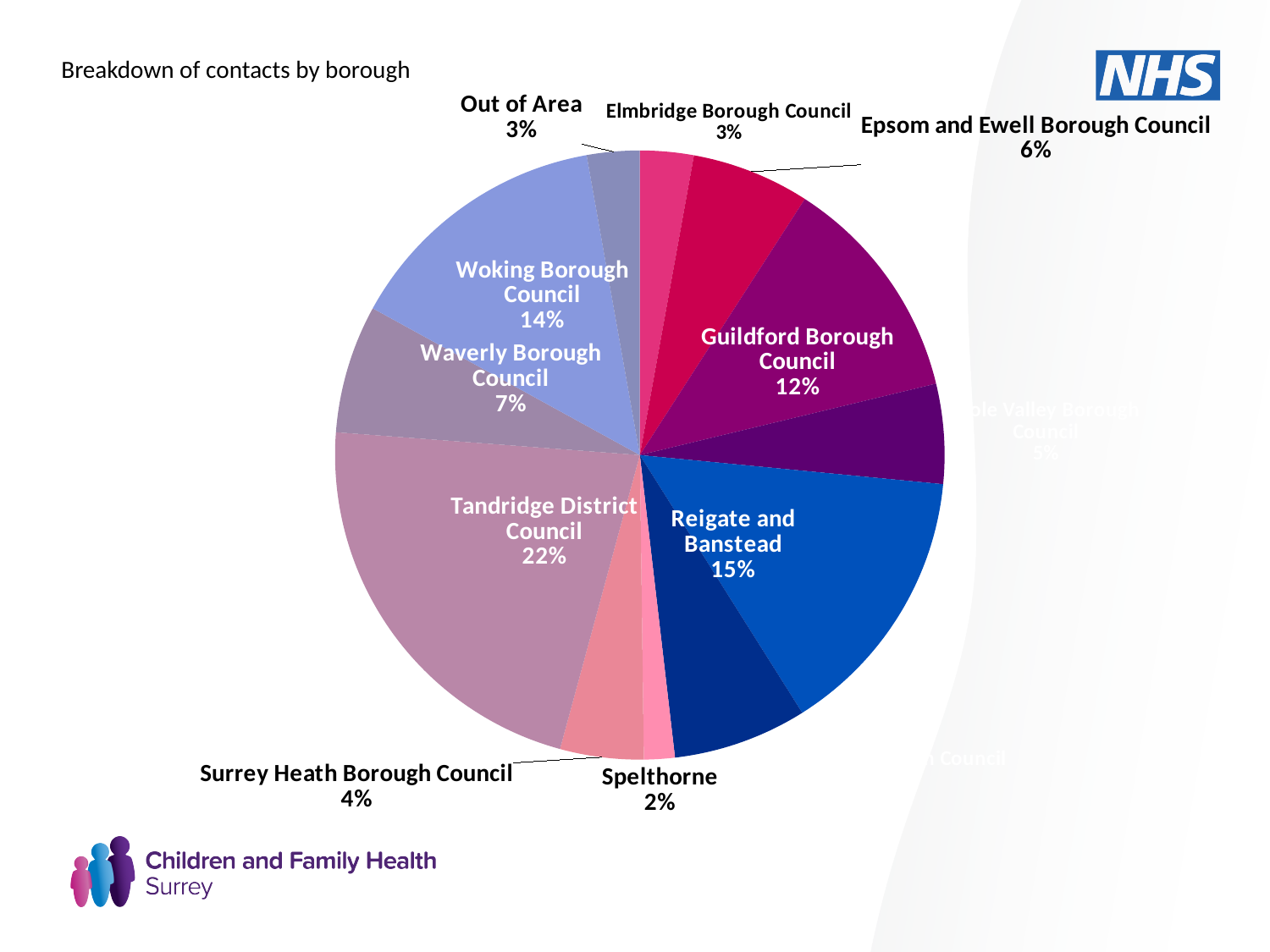
What percentage of contacts is from Woking Borough Council? 14% What percentage of contacts is from Reigate and Banstead? 15% What percentage of contacts is from Surrey Heath Borough Council? 4% What kind of chart is shown on the slide? pie chart What is the title of the chart? Breakdown of contacts by borough Which labelled borough has the smallest share of contacts? Spelthorne What share of contacts is from Tandridge District Council? 22% How many percentage points larger is the Tandridge District Council share than the Reigate and Banstead share? 7 Which has a larger share of contacts, Woking Borough Council or Waverly Borough Council? Woking Borough Council Which borough has the largest share of contacts? Tandridge District Council What percentage of contacts is from Guildford Borough Council? 12% What percentage of contacts is from Epsom and Ewell Borough Council? 6%